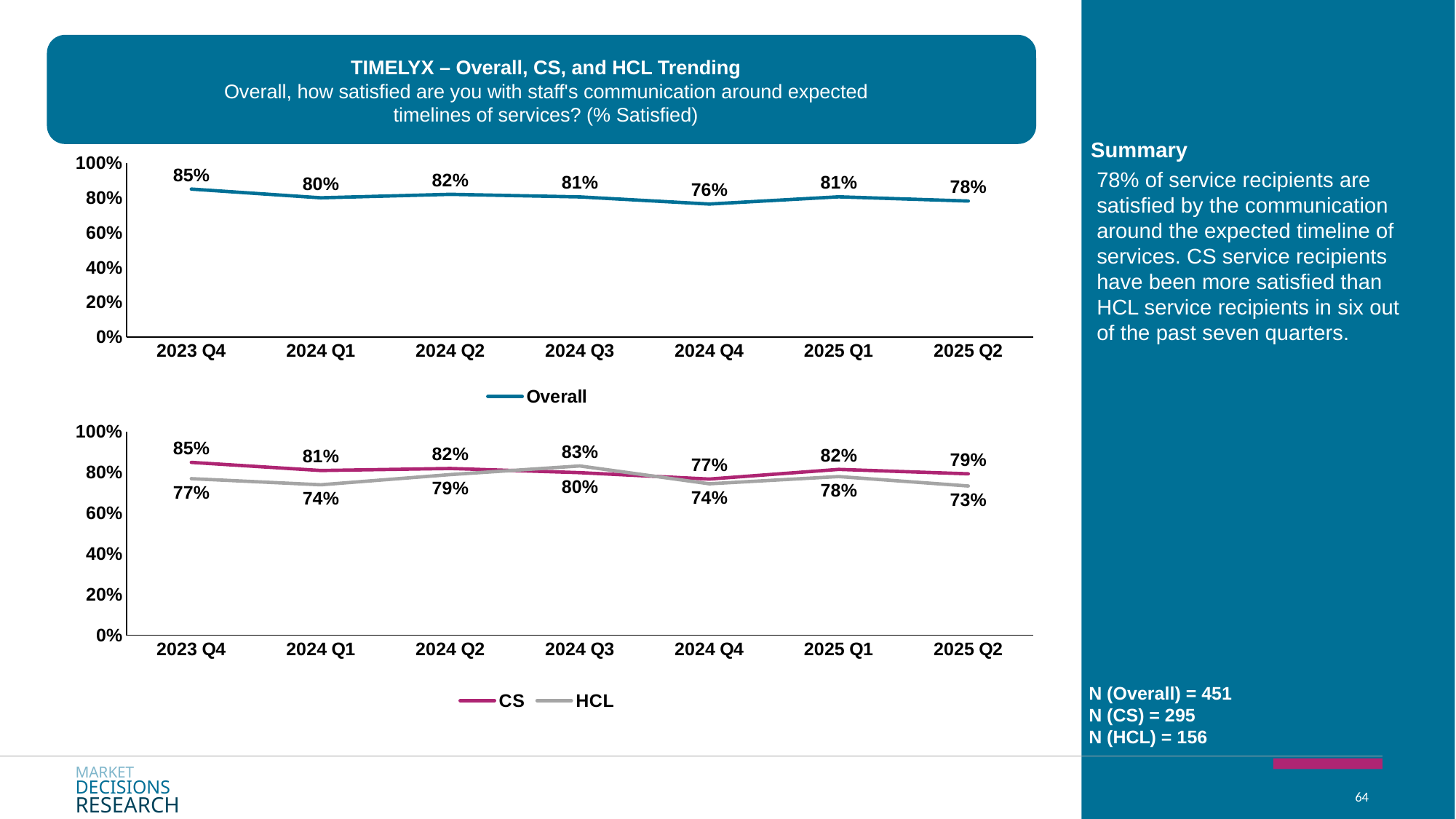
What kind of chart is the top chart? Line chart In the bottom chart, what is the CS value for 2025 Q1? 82% In the bottom chart, which quarter has the lowest HCL value? 2025 Q2 How many quarters are shown on the x axis of the top chart? 7 In the bottom chart, what is the HCL value for 2025 Q2? 73% In the top chart (Overall), what is the value for 2024 Q4? 76% In the top chart (Overall), which quarter has the highest value? 2023 Q4 In the bottom chart, which series has the higher value in 2024 Q3, CS or HCL? HCL In the top chart (Overall), which quarter has the lowest value? 2024 Q4 How many series does the legend of the bottom chart list? 2 In the top chart (Overall), what is the difference between the 2023 Q4 value and the 2025 Q2 value? 7 percentage points In the bottom chart, what is the difference between the CS and HCL values in 2024 Q1? 7 percentage points